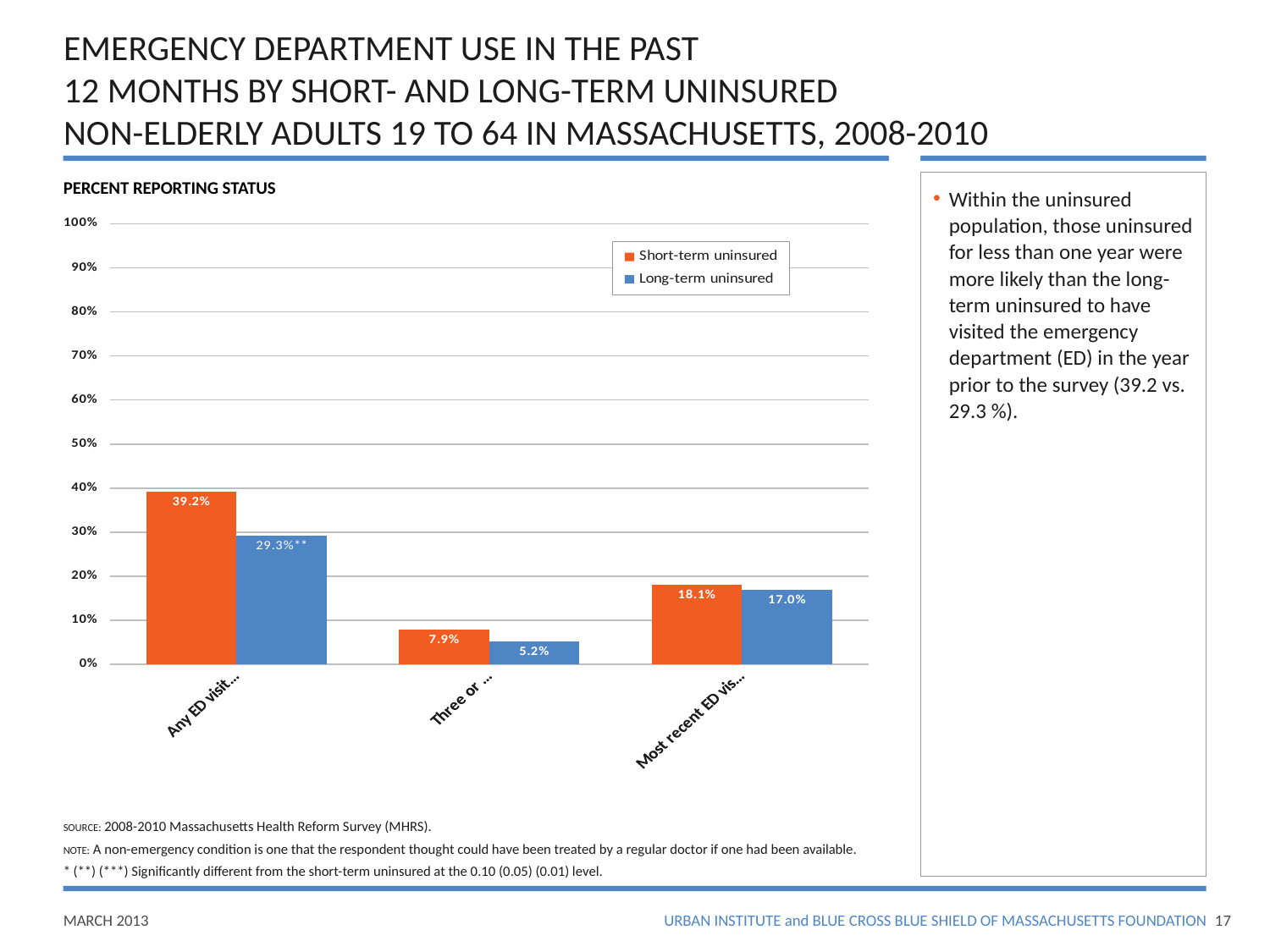
Which category has the highest Short-term uninsured value? Any ED visit What is the value for Short-term uninsured in the 'Any ED visit' category? 39.2% What is the value for Long-term uninsured in the 'Any ED visit' category? 29.3% How many series does the legend list? 2 In the second category from the left, which is larger: Short-term uninsured or Long-term uninsured? Short-term uninsured Which category has the lowest Long-term uninsured value? the second category (Three or ...) What is the value for Short-term uninsured in the second category from the left? 7.9% Which colour represents Long-term uninsured in the legend? blue What is the difference between the Short-term uninsured and Long-term uninsured values in the 'Any ED visit' category? 9.9 percentage points What is the value for Long-term uninsured in the third category from the left? 17.0% How many categories are shown on the x axis? 3 What type of chart is shown on the slide? bar chart